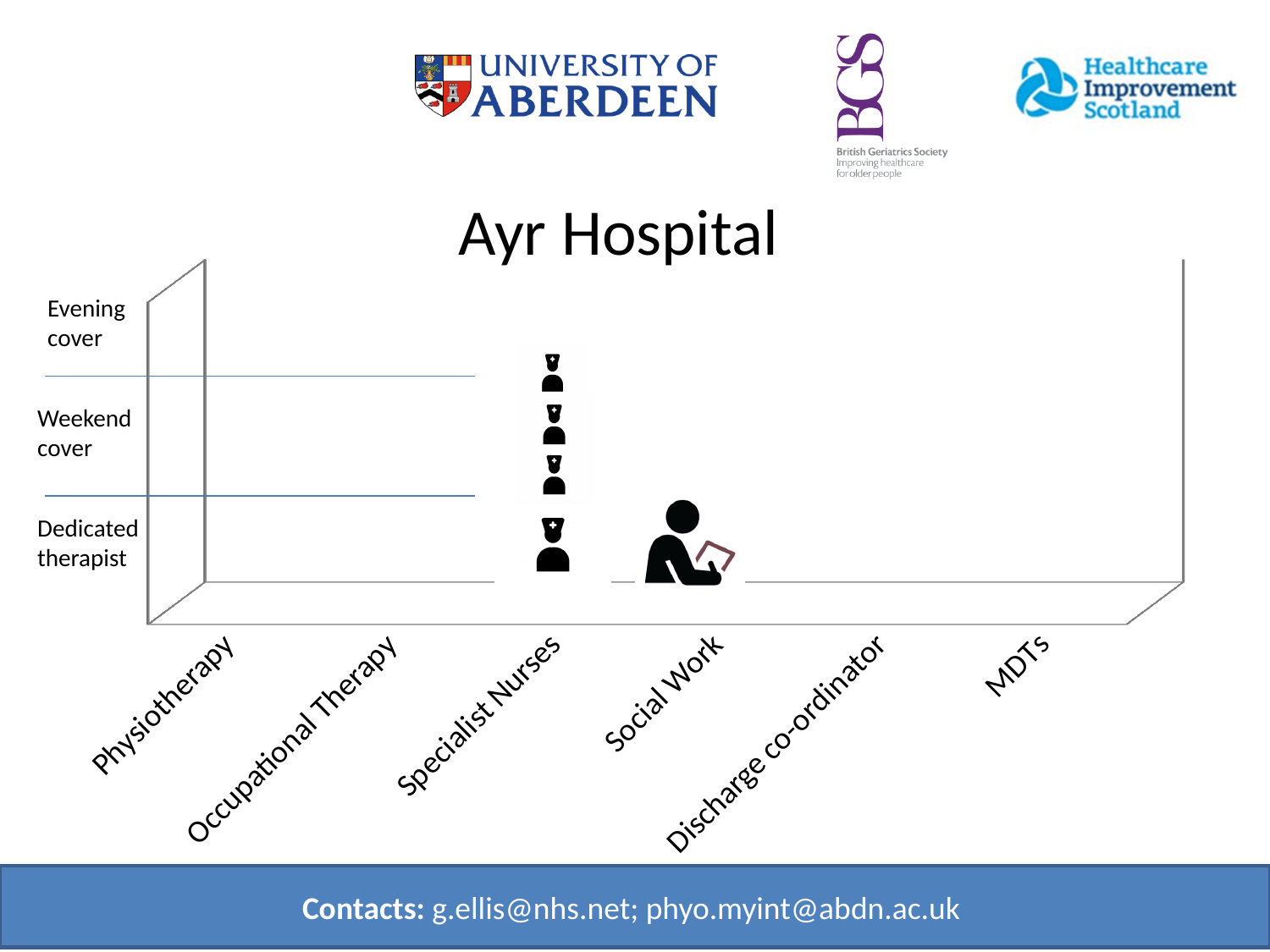
How many nurse icons are stacked above Specialist Nurses? 4 What is the title of the chart? Ayr Hospital Which category is the last one on the x axis? MDTs Which category, Specialist Nurses or Social Work, has the taller stack of icons? Specialist Nurses How many categories have no icons plotted? 4 Which level does the Social Work icon reach on the y axis? Dedicated therapist What are the three levels labelled on the y axis, from bottom to top? Dedicated therapist, Weekend cover, Evening cover Does the Physiotherapy category have any icons plotted? No Which two categories have icons plotted? Specialist Nurses and Social Work Which level does the stack of Specialist Nurses icons reach on the y axis? Evening cover How many categories are listed along the x axis of the chart? 6 Which category has the tallest stack of icons in the chart? Specialist Nurses